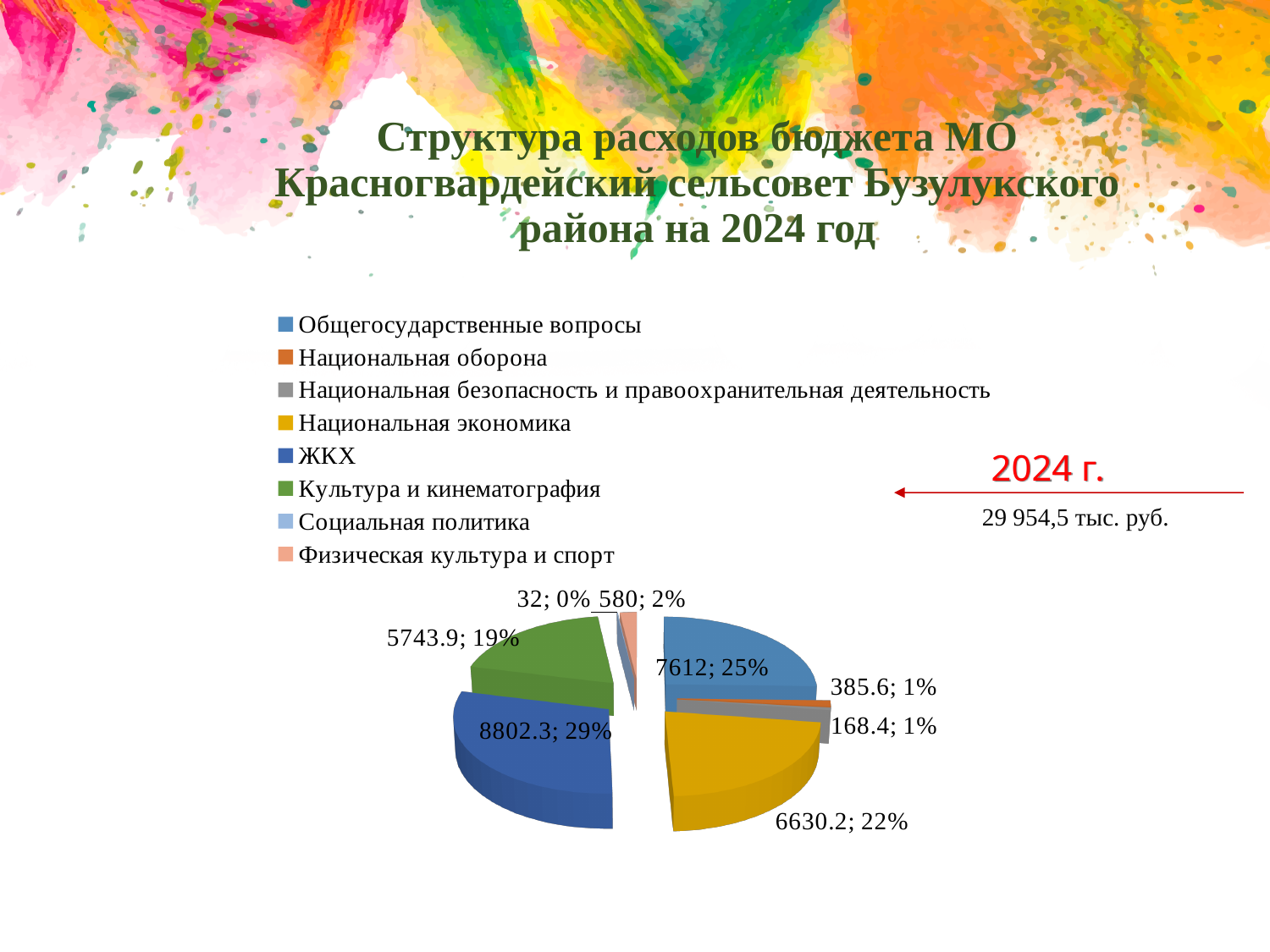
What value is shown for Общегосударственные вопросы? 7612 Which category has the smallest slice in the pie chart? Социальная политика What percentage share does Национальная экономика have in the pie chart? 22% Which category has the largest slice in the pie chart? ЖКХ What type of chart is shown on the slide? pie chart What value is shown for ЖКХ in the pie chart? 8802.3 What total budget amount for 2024 is stated next to the chart? 29 954,5 тыс. руб. Which is larger: the value for Национальная оборона or the value for Национальная безопасность и правоохранительная деятельность? Национальная оборона What value is shown for Физическая культура и спорт? 580 How many categories does the legend of the pie chart list? 8 What percentage share does Культура и кинематография have? 19% What is the difference between the values for ЖКХ and Общегосударственные вопросы? 1190.3